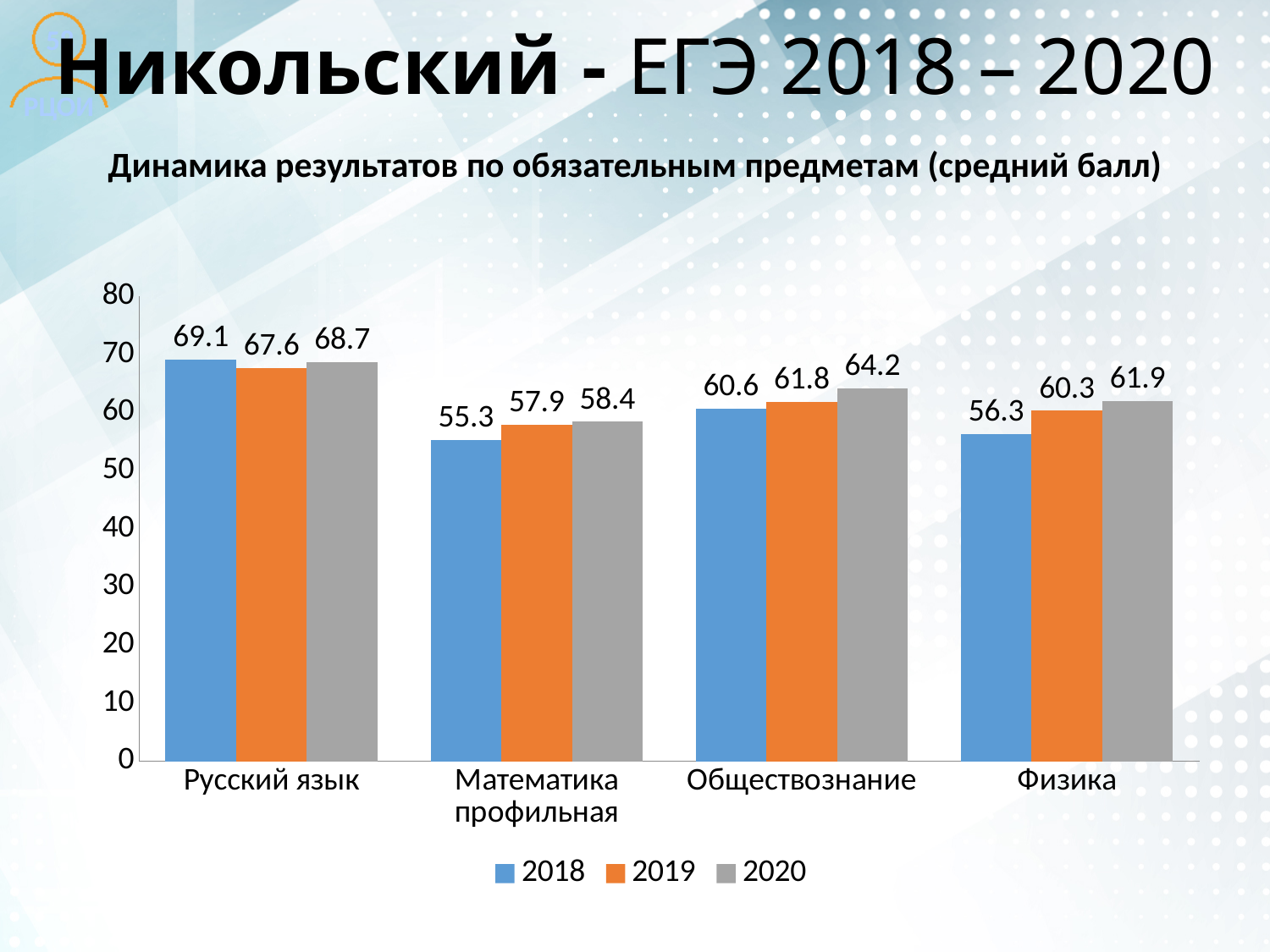
Is the value for Физика in 2018 greater or less than 60? less What is the value for Русский язык in 2018? 69.1 What is the value for Физика in 2019? 60.3 How many series does the legend list? 3 What kind of chart is shown on the slide? bar chart What is the value for Математика профильная in 2020? 58.4 Which category has the highest value in the 2020 series? Русский язык What is the difference between the 2020 and 2018 values for Обществознание? 3.6 Do the values for Математика профильная rise or fall from 2018 to 2020? rise How many categories are shown on the x axis? 4 Which is larger for Русский язык: the 2018 value or the 2019 value? 2018 Which category has the lowest value in the 2018 series? Математика профильная